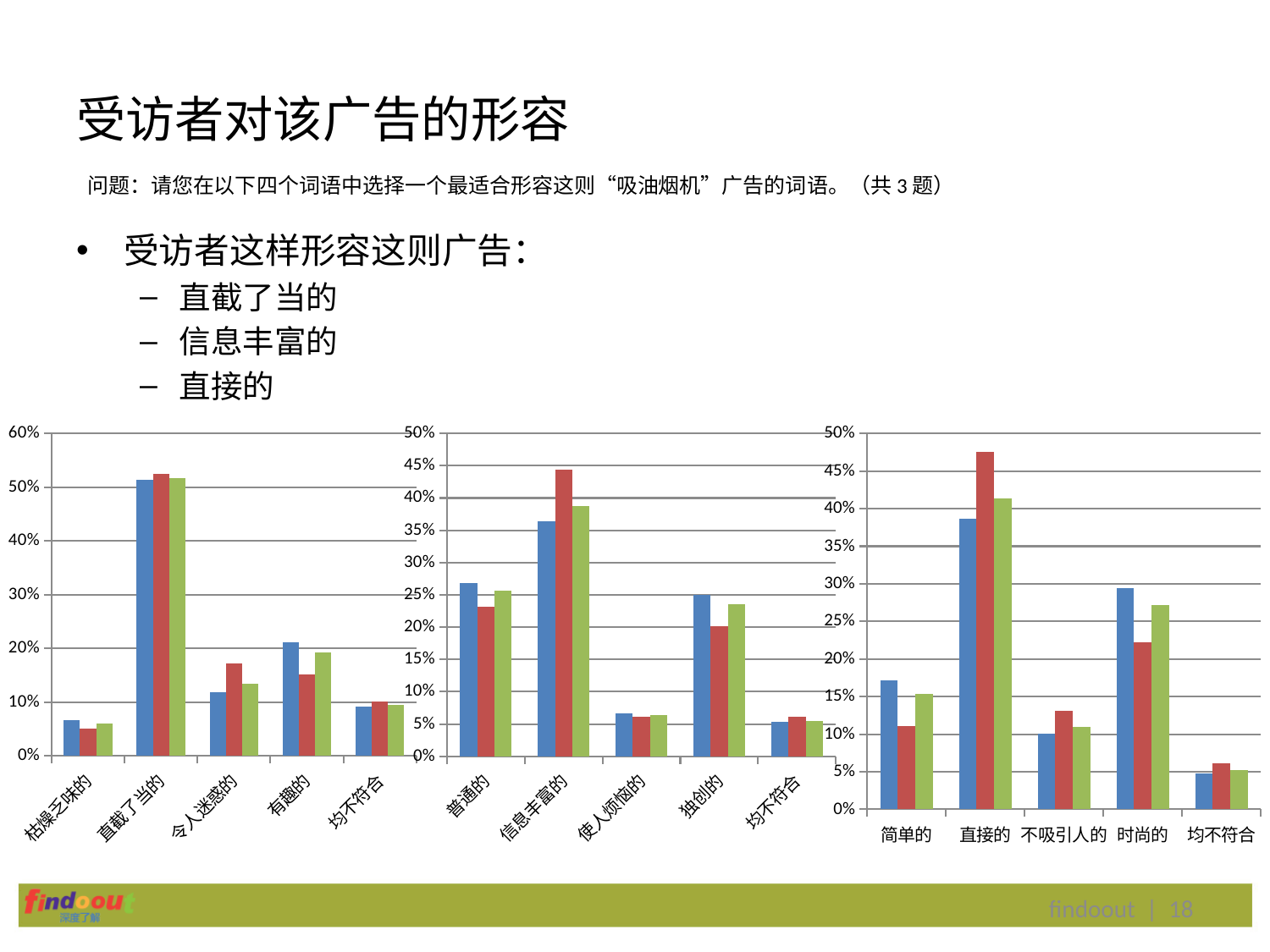
In the left chart, is the value of the red bar for 令人迷惑的 greater or less than 10%? greater What kind of chart is the left chart on the slide? bar chart In the right chart, which category has the lowest values? 均不符合 In the right chart, which category has the highest values? 直接的 In the middle chart, is the value of the red bar for 信息丰富的 greater or less than 40%? greater How many categories are shown on the x axis of the left chart? 5 In the right chart, is the value of the blue bar for 时尚的 greater or less than 25%? greater How many bars are shown for each category in the right chart? 3 In the left chart, which category has the highest values? 直截了当的 In the middle chart, which has the larger blue bar, 独创的 or 使人烦恼的? 独创的 In the left chart, which category has the lowest values? 枯燥乏味的 In the middle chart, which category has the highest values? 信息丰富的